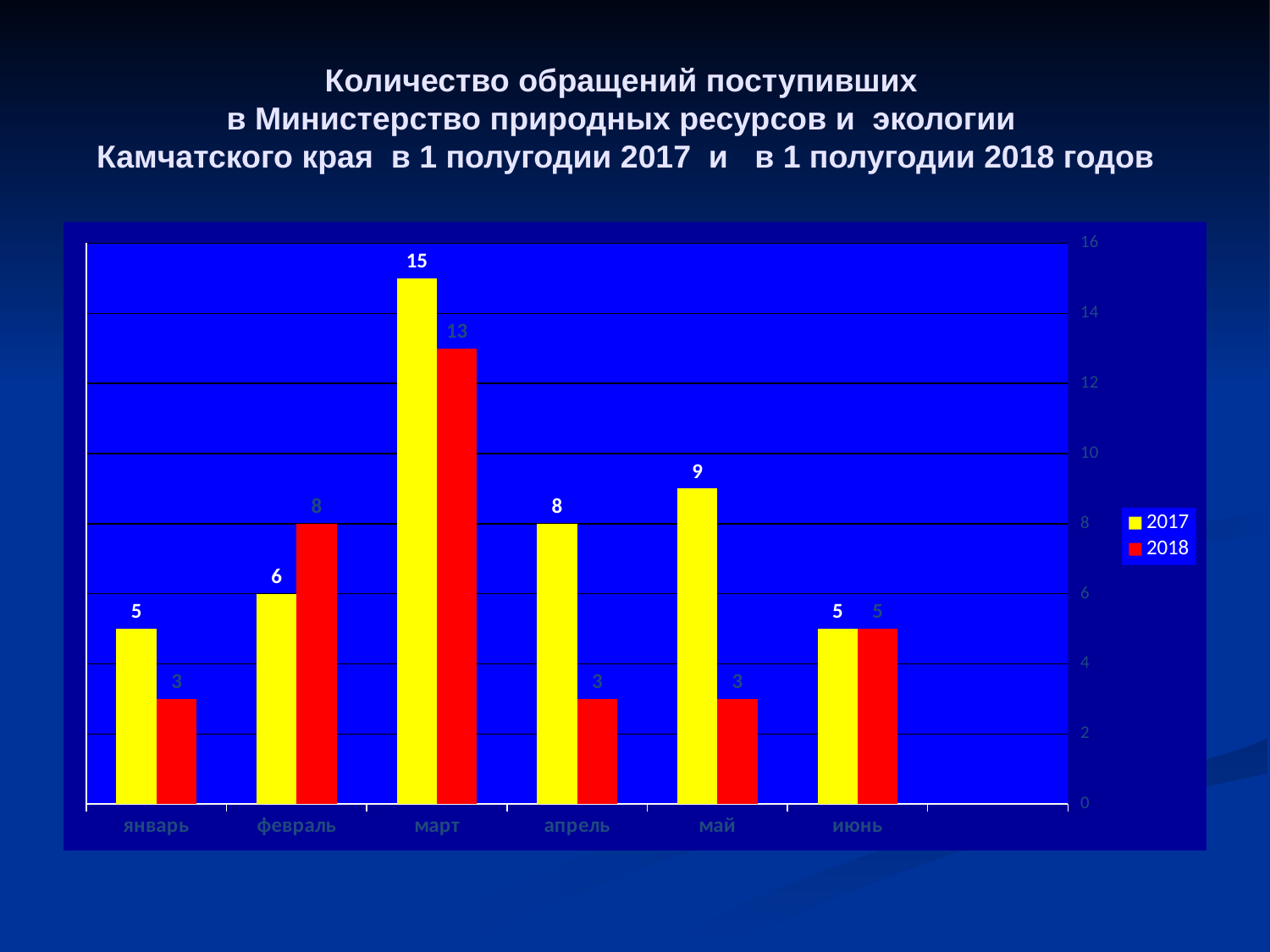
Which is larger in февраль, the 2017 value or the 2018 value? 2018 What is the value for 2017 in март? 15 Which month has the highest value for the 2017 series? март What is the difference between the 2017 and 2018 values in март? 2 Which month has the lowest value for the 2017 series? январь and июнь (both 5) How many months are shown on the x axis? 6 How many series does the legend list? 2 What type of chart is shown on the slide? bar chart What is the value for 2018 in февраль? 8 What is the value for 2018 in апрель? 3 Is the value for 2017 in май greater or less than 8? greater Which colour represents the 2018 series in the legend? red